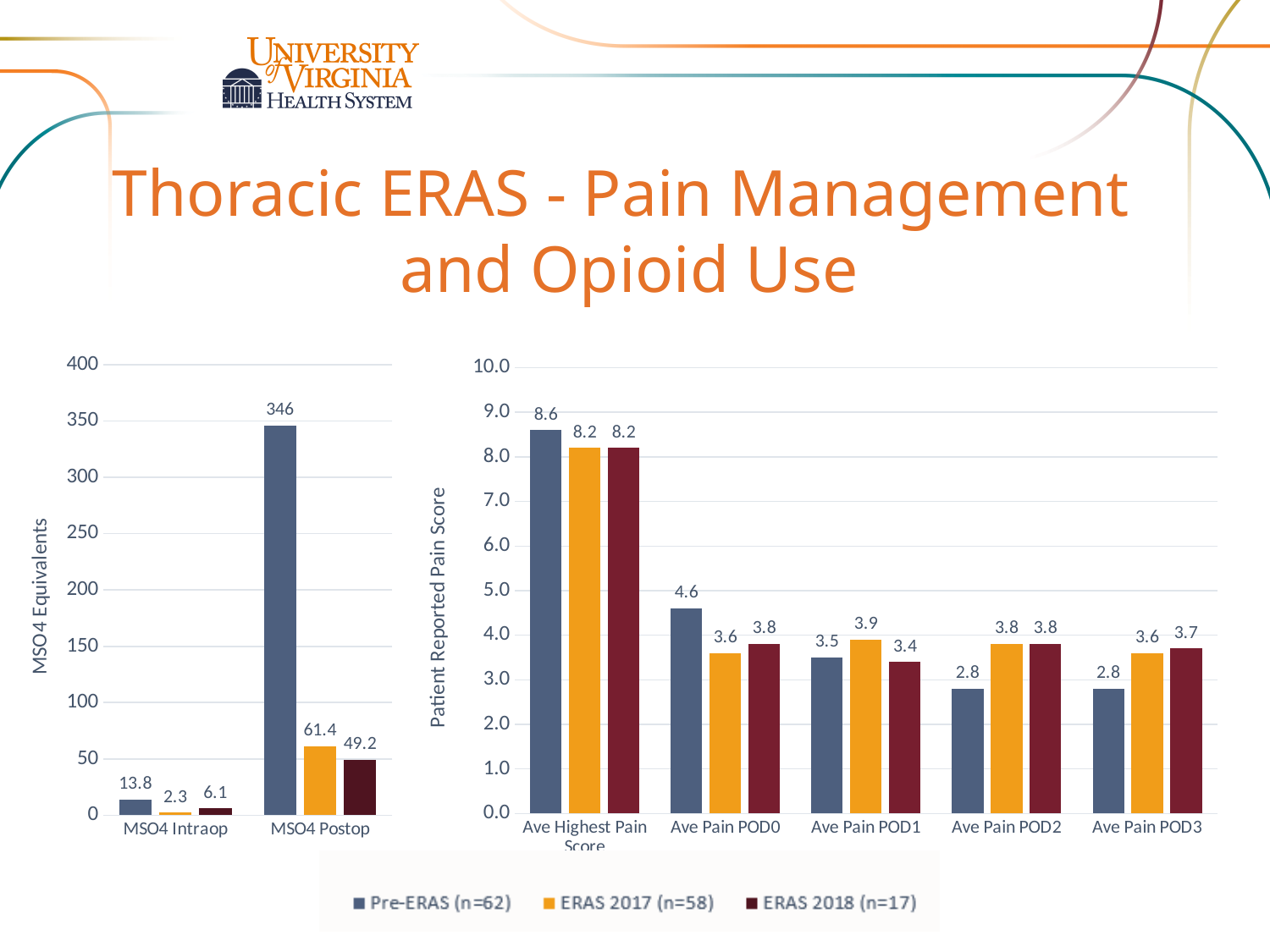
What type of chart is the right chart (Patient Reported Pain Score)? Bar chart In the left chart (MSO4 Equivalents), is the Pre-ERAS value for MSO4 Postop greater or less than 300? greater In the left chart (MSO4 Equivalents), which series has the highest value for MSO4 Intraop? Pre-ERAS (n=62) In the right chart (Patient Reported Pain Score), which is larger for Ave Pain POD1: the Pre-ERAS value or the ERAS 2017 value? ERAS 2017 In the right chart (Patient Reported Pain Score), what is the Pre-ERAS value for Ave Pain POD0? 4.6 In the left chart (MSO4 Equivalents), what is the difference between the Pre-ERAS and ERAS 2018 values for MSO4 Postop? 296.8 In the right chart (Patient Reported Pain Score), how many categories are shown on the x axis? 5 In the right chart (Patient Reported Pain Score), which series has the lowest value for Ave Pain POD2? Pre-ERAS (n=62) In the right chart (Patient Reported Pain Score), what is the ERAS 2018 value for Ave Pain POD3? 3.7 How many series does the legend list? 3 In the left chart (MSO4 Equivalents), what is the ERAS 2017 value for MSO4 Intraop? 2.3 In the left chart (MSO4 Equivalents), what is the Pre-ERAS value for MSO4 Postop? 346